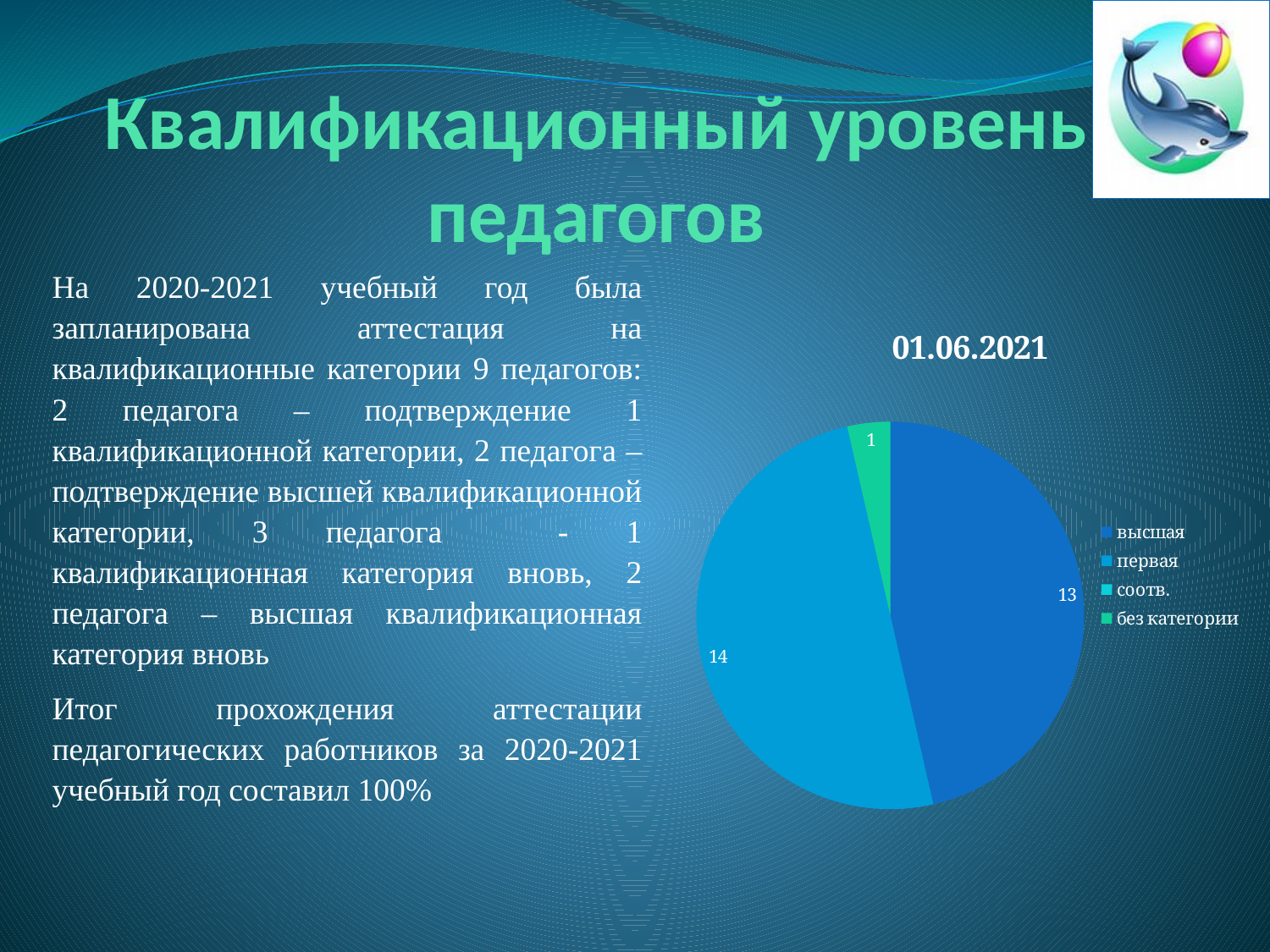
How many entries does the legend of the pie chart list? 4 Which labelled category has the smallest slice in the pie chart? без категории What value is shown for the "первая" slice in the pie chart? 14 What is the difference between the "первая" and "высшая" values in the pie chart? 1 What is the title of the pie chart? 01.06.2021 What type of chart is shown on the slide? pie chart What is the total of the three labelled slices in the pie chart? 28 What value is shown for the "высшая" slice in the pie chart? 13 Which category has the largest slice in the pie chart? первая Which is larger in the pie chart, "высшая" or "соотв."? высшая